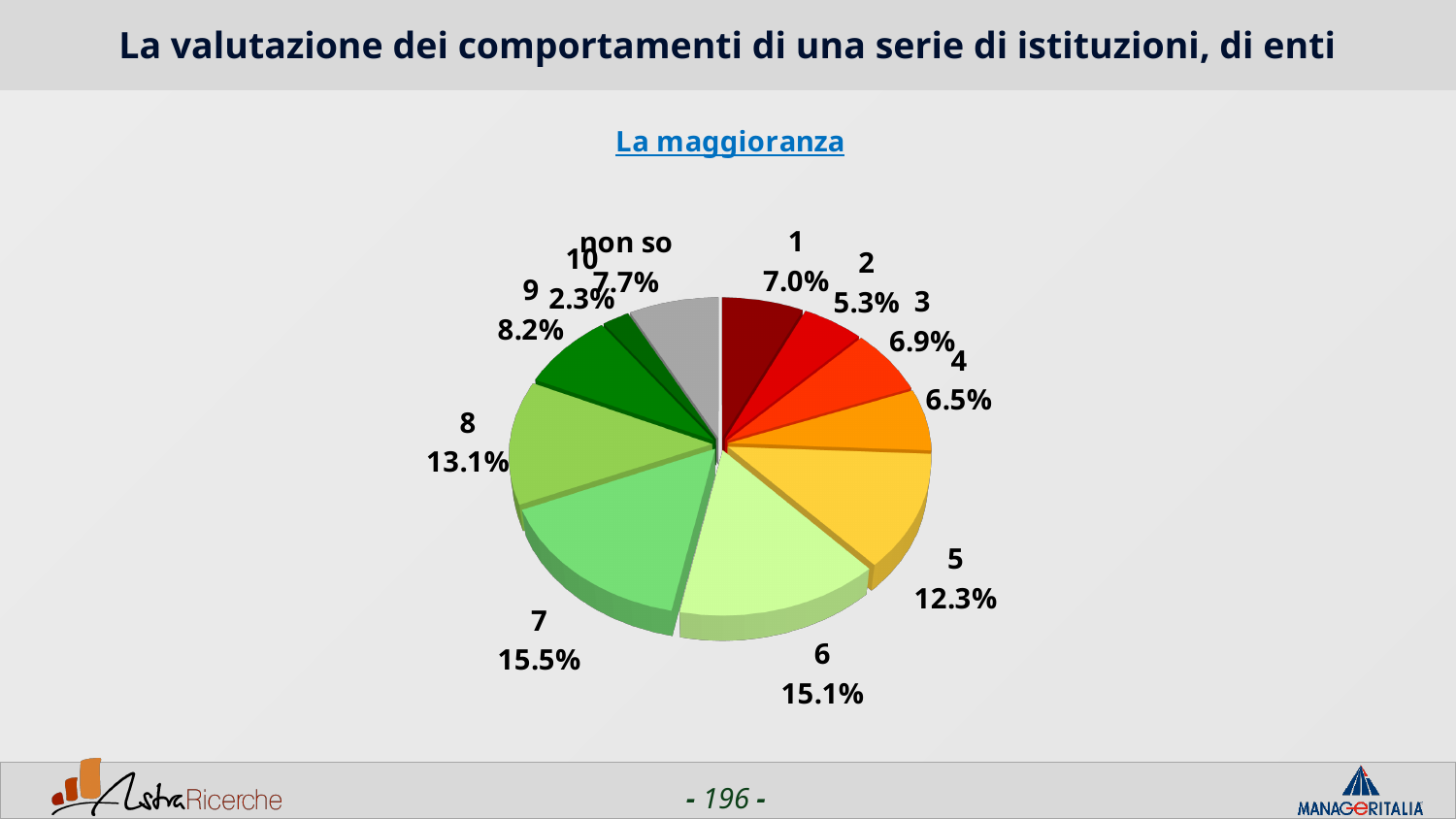
What is the title of the pie chart? La maggioranza What is the value for category 5? 12.3% Which is larger, the value for category 1 or the value for category 3? 1 How many slices does the pie chart have? 11 What is the difference between the values for category 6 and category 4? 8.6% Which category has the largest slice? 7 Which category has the smallest slice? 10 What is the value for category 2? 5.3% What is the value for category 7? 15.5% What is the value for the 'non so' slice? 7.7% What is the difference between the values for category 8 and category 9? 4.9% What type of chart is shown on the slide? pie chart